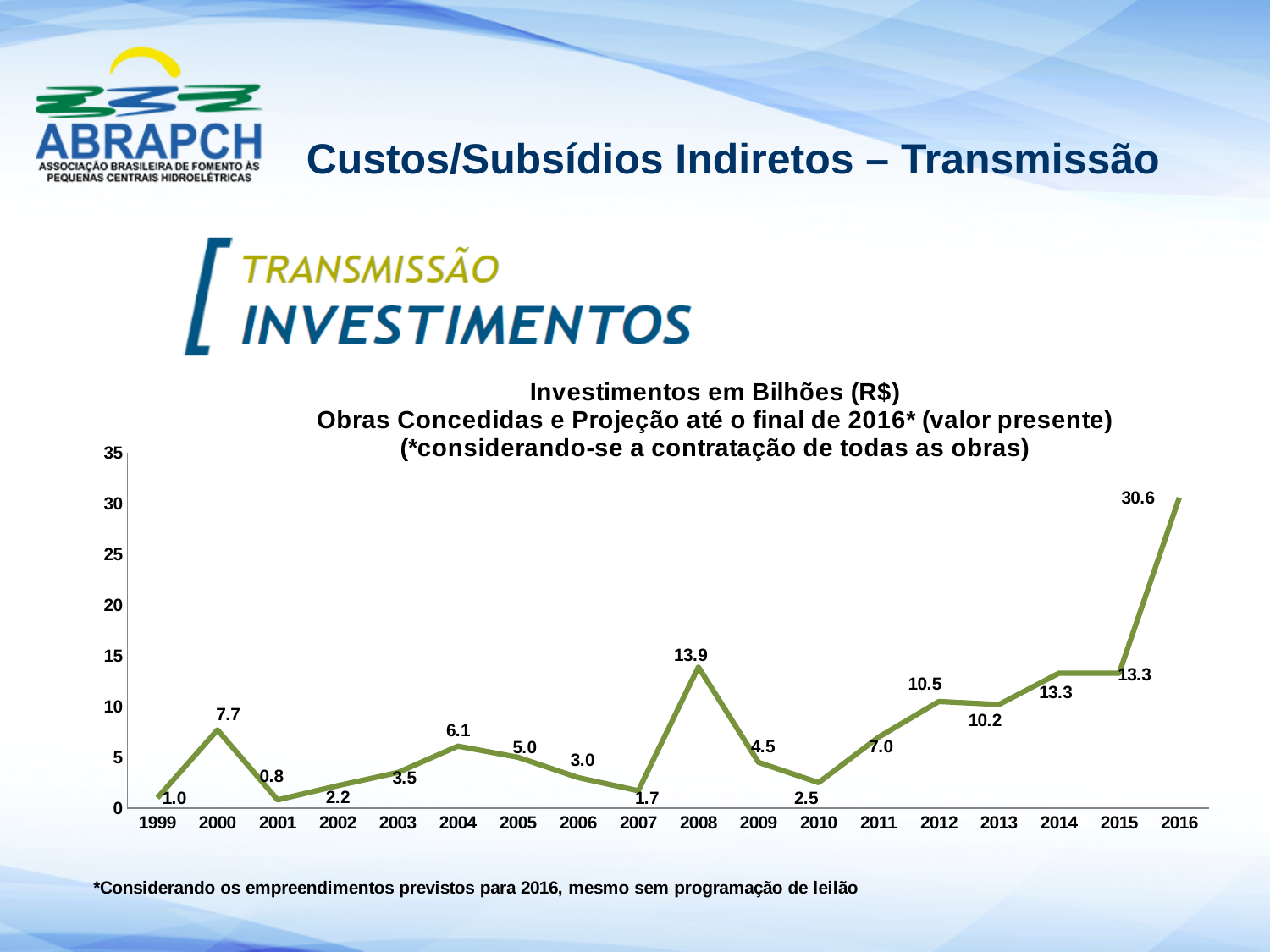
What is the investment value for 2008? 13.9 Do the investment values rise or fall from 2010 to 2012? rise Which year has the lowest investment value? 2001 What is the difference between the investment values for 2016 and 2015? 17.3 How many years are plotted on the x axis? 18 Which year has a larger investment value, 2000 or 2004? 2000 What is the first line of the chart title? Investimentos em Bilhões (R$) Is the investment value for 2012 greater or less than 10? greater What type of chart is shown on the slide? line chart Which year has the highest investment value? 2016 What is the investment value for 2001? 0.8 What is the investment value for 2016? 30.6